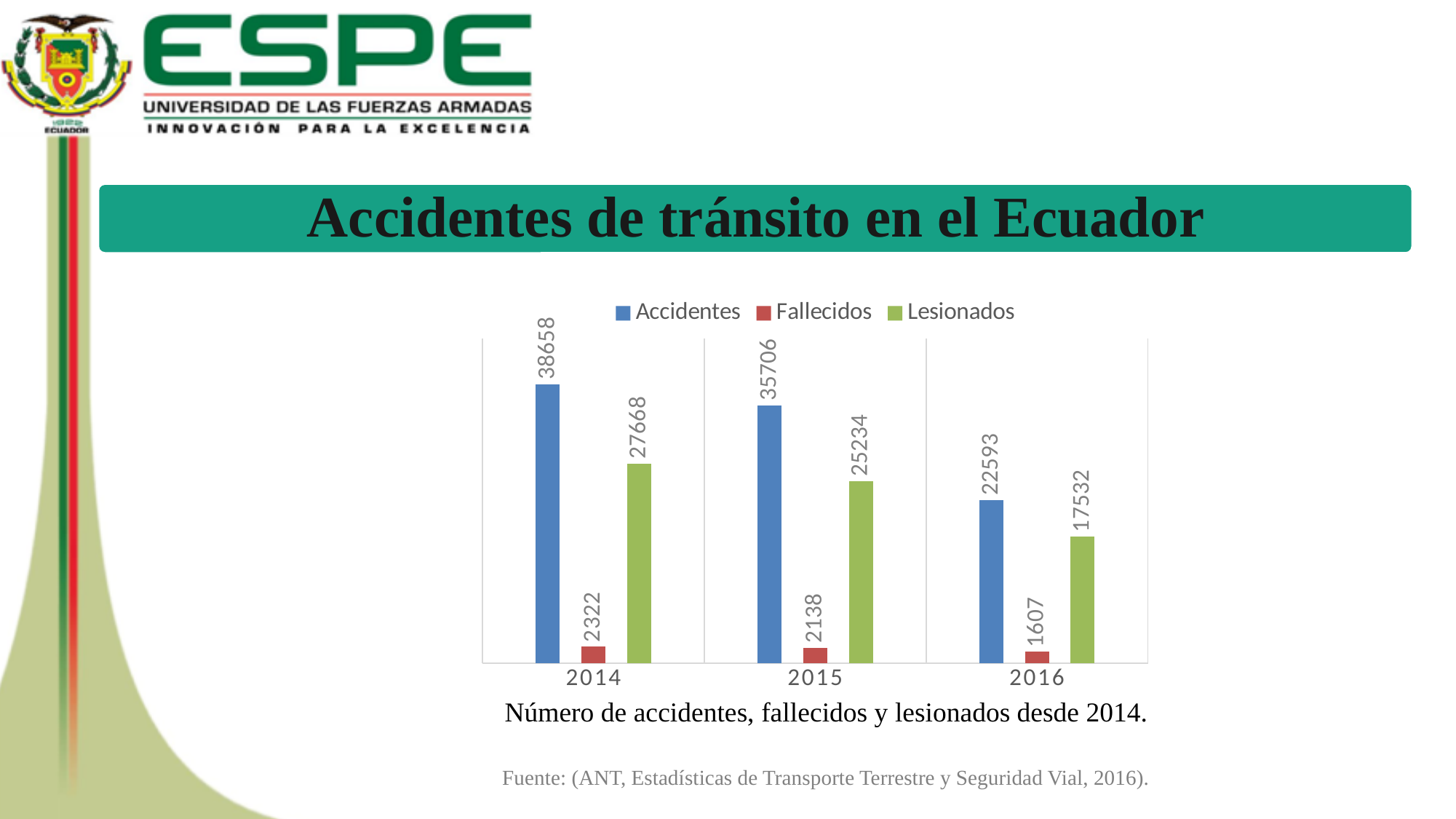
What is the value of Fallecidos in 2016? 1607 What is the value of Lesionados in 2015? 25234 Which is larger: Lesionados in 2014 or Accidentes in 2016? Lesionados in 2014 How many years are shown on the x axis? 3 Do the Accidentes values rise or fall from 2014 to 2016? Fall What is the value of Accidentes in 2014? 38658 What is the difference between Fallecidos in 2014 and Fallecidos in 2015? 184 What kind of chart is shown on the slide? Bar chart Which year has the highest value for Accidentes? 2014 Which year has the lowest value for Lesionados? 2016 How many series does the legend list? 3 What is the difference between Accidentes in 2014 and Accidentes in 2016? 16065